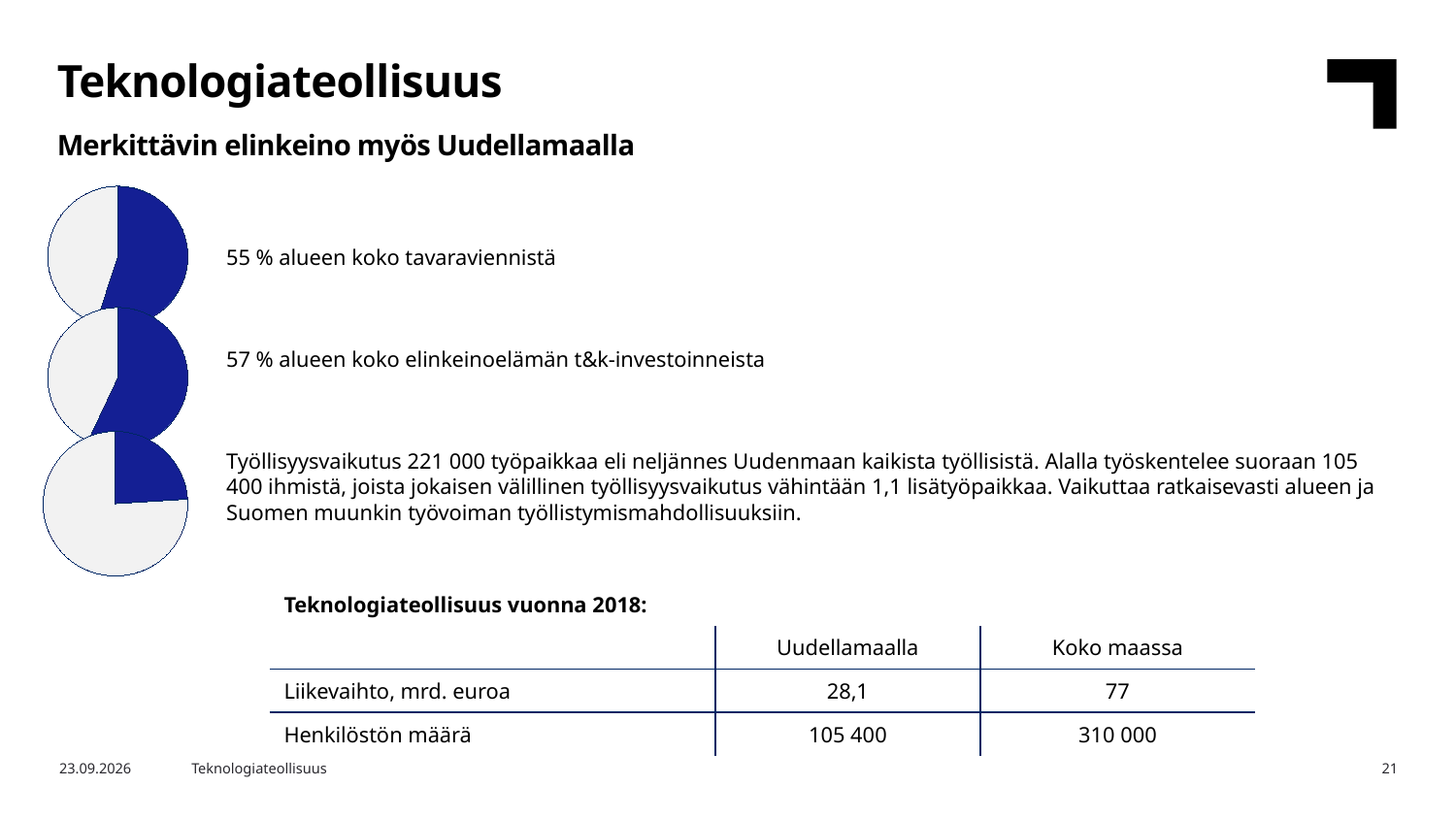
In the top pie chart, what share of the region's total goods exports (tavaravienti) does the blue slice represent? 55 % What kind of chart is shown at the top left of the slide? pie chart In the middle pie chart, what share of the region's business R&D investments (t&k-investoinnit) does the blue slice represent? 57 % Is the blue slice in the bottom pie chart larger or smaller than the blue slice in the top pie chart? smaller What colour is the highlighted slice in each of the pie charts? blue Is the blue slice in the bottom pie chart larger or smaller than the blue slice in the middle pie chart? smaller What colour is the remaining (non-highlighted) slice in the pie charts? light grey Which of the three pie charts has the smallest blue slice? the bottom pie chart How many pie charts are on the slide? 3 How many slices does the top pie chart have? 2